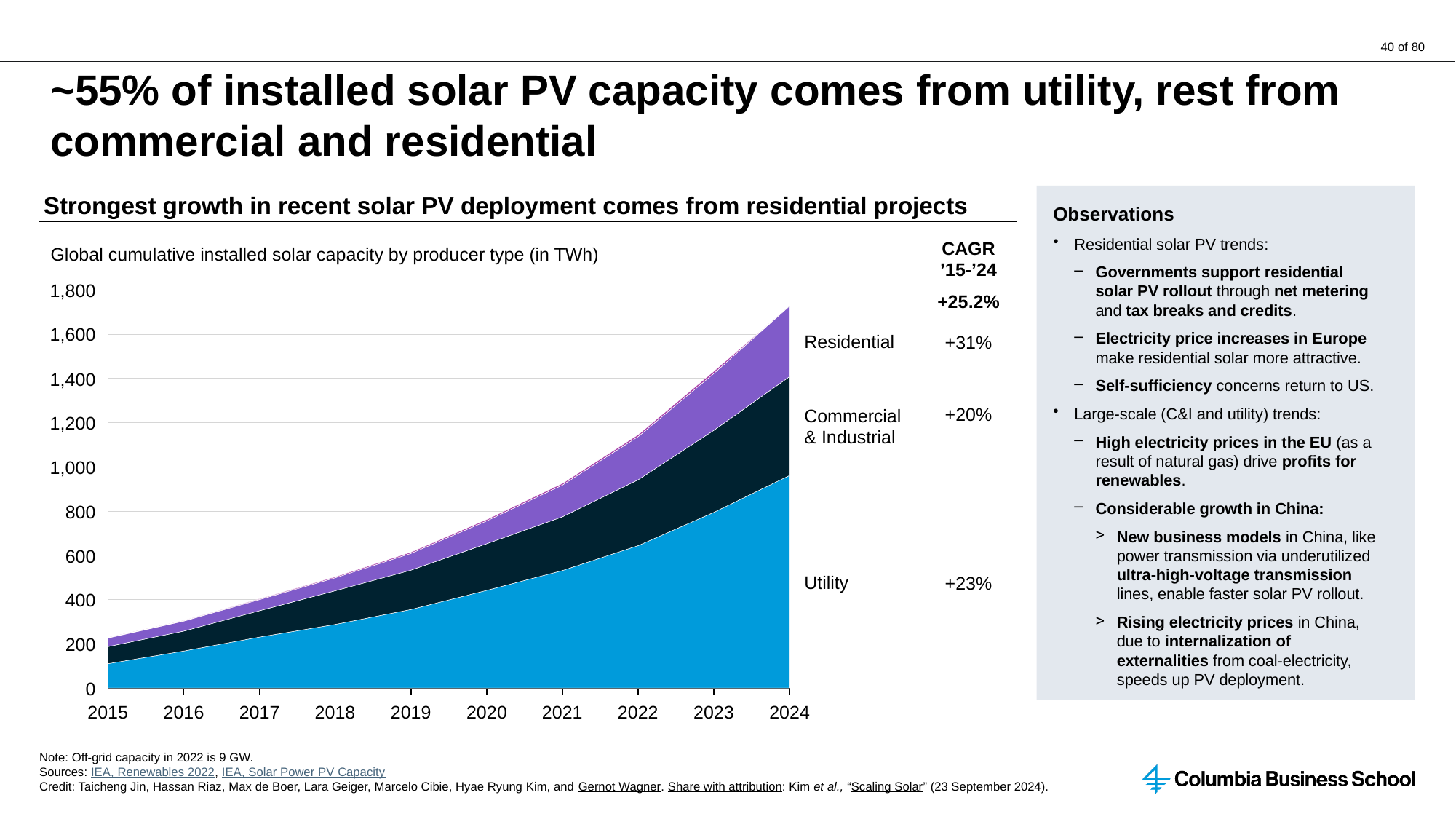
Is the total installed solar capacity in 2015 greater or less than 400? less What kind of chart is shown on the slide? Stacked area chart What is the CAGR '15-'24 shown for Commercial & Industrial? +20% Which has a higher CAGR '15-'24, Utility or Commercial & Industrial? Utility What is the CAGR '15-'24 shown for Residential? +31% What is the overall CAGR '15-'24 shown at the top of the CAGR column? +25.2% Which producer type has the lowest CAGR '15-'24? Commercial & Industrial Does the total global cumulative installed solar capacity rise or fall from 2015 to 2024? Rise Is the total installed solar capacity in 2024 greater or less than 1,600? greater How many years are shown on the x axis of the chart? 10 Which producer type has the highest CAGR '15-'24? Residential What is the CAGR '15-'24 shown for Utility? +23%